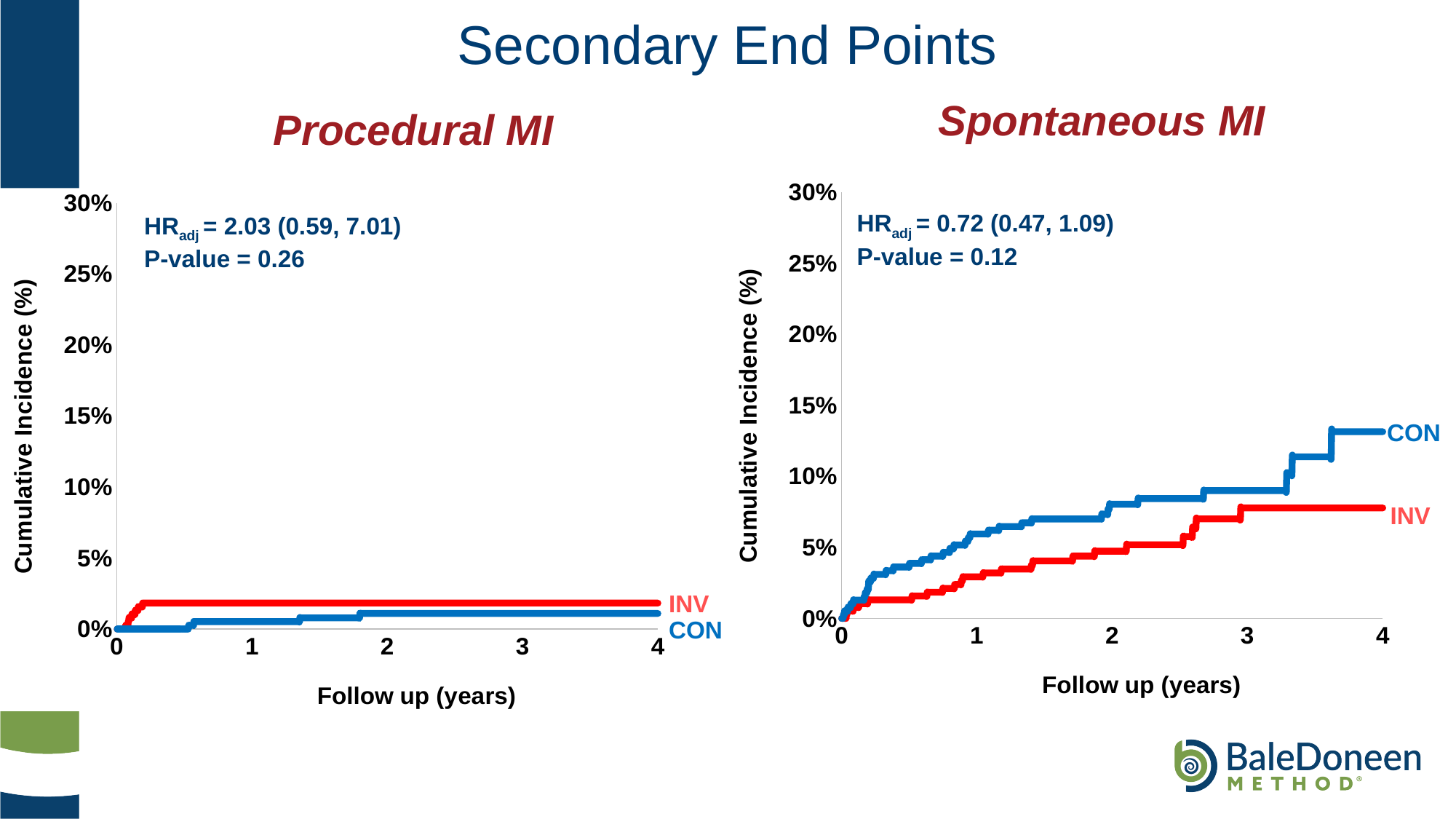
What is the y-axis label on the Procedural MI chart? Cumulative Incidence (%) On the Procedural MI chart, is the value for INV at 4 years greater or less than 5%? less On the Spontaneous MI chart, is the value for INV at 4 years greater or less than 5%? greater On the Spontaneous MI chart, is the value for CON at 4 years greater or less than 15%? less On the Spontaneous MI chart, which series is higher at 4 years of follow up, CON or INV? CON On the Spontaneous MI chart, does the CON curve rise or fall as follow up years increase? rise How many series are plotted on the Spontaneous MI chart? 2 On the Procedural MI chart, which series is higher at 4 years of follow up, CON or INV? INV What kind of chart is the Procedural MI chart? line chart What P-value is shown on the Spontaneous MI chart? 0.12